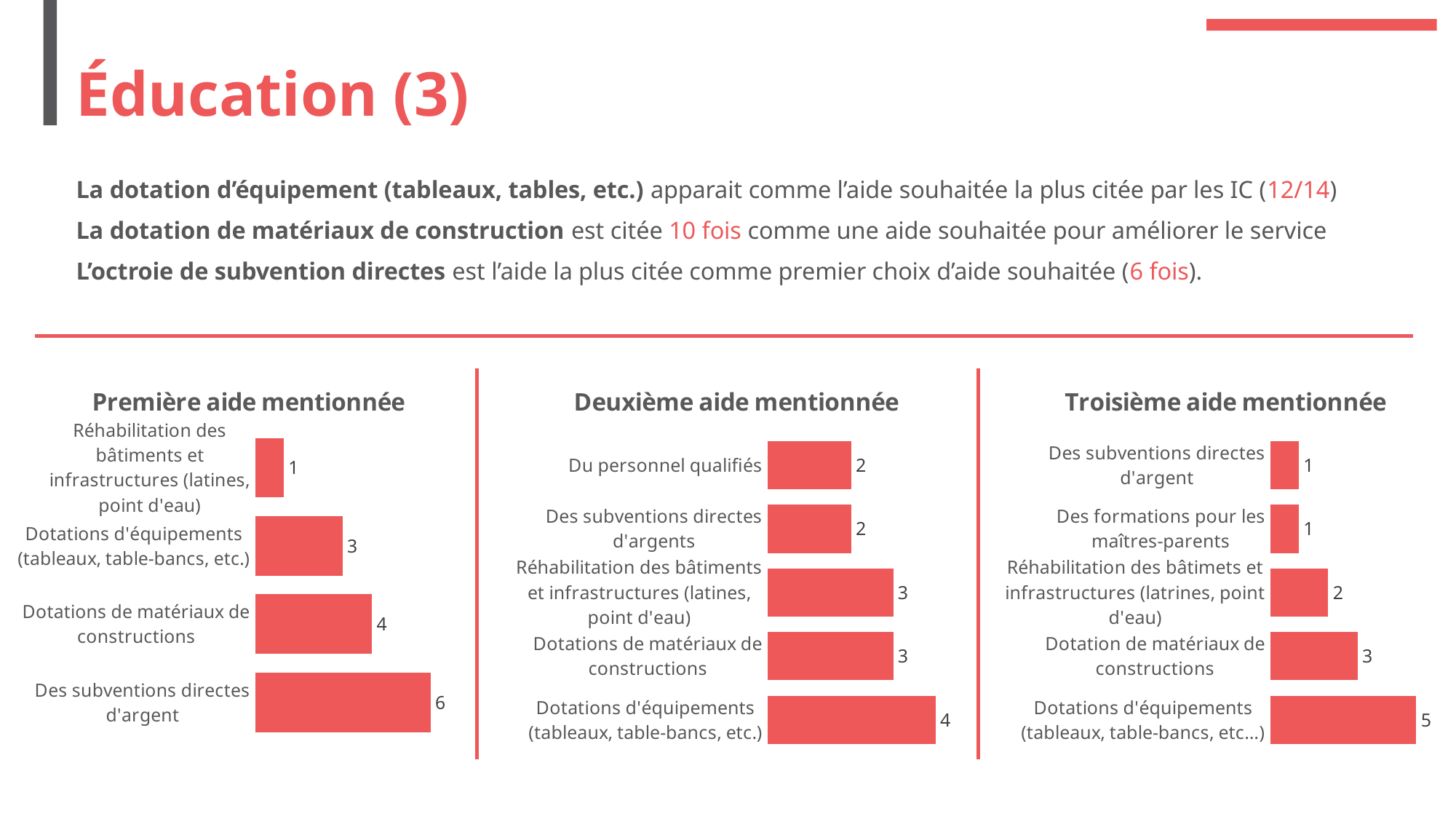
In the 'Deuxième aide mentionnée' chart, which category has the highest value? Dotations d'équipements (tableaux, table-bancs, etc.) How many categories does the 'Première aide mentionnée' chart show? 4 In the 'Deuxième aide mentionnée' chart, what is the value for 'Dotations d'équipements (tableaux, table-bancs, etc.)'? 4 What kind of chart is the 'Première aide mentionnée' chart? Bar chart In the 'Troisième aide mentionnée' chart, what is the difference between 'Dotations d'équipements (tableaux, table-bancs, etc...)' and 'Des subventions directes d'argent'? 4 In the 'Troisième aide mentionnée' chart, which category has the highest value? Dotations d'équipements (tableaux, table-bancs, etc...) In the 'Première aide mentionnée' chart, which category has the lowest value? Réhabilitation des bâtiments et infrastructures (latines, point d'eau) In the 'Troisième aide mentionnée' chart, which is larger: 'Réhabilitation des bâtimets et infrastructures (latrines, point d'eau)' or 'Des formations pour les maîtres-parents'? Réhabilitation des bâtimets et infrastructures (latrines, point d'eau) In the 'Première aide mentionnée' chart, what is the difference between 'Des subventions directes d'argent' and 'Dotations de matériaux de constructions'? 2 How many categories does the 'Deuxième aide mentionnée' chart show? 5 In the 'Troisième aide mentionnée' chart, what is the value for 'Dotation de matériaux de constructions'? 3 In the 'Première aide mentionnée' chart, what is the value for 'Des subventions directes d'argent'? 6